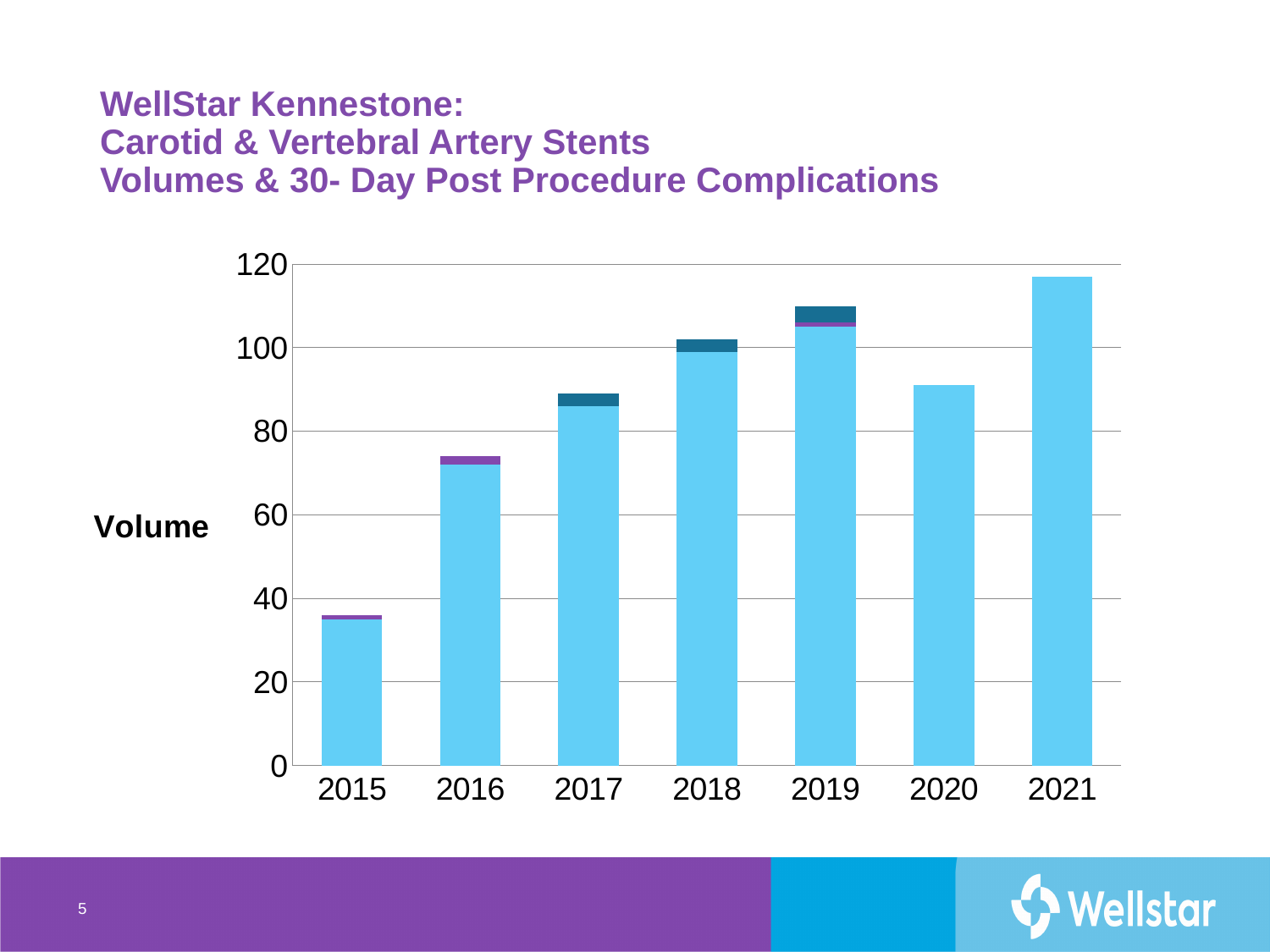
Is the value for 2021 greater or less than 100? greater Do the bars rise or fall from 2015 to 2019? rise What is the title of the vertical axis? Volume Is the value for 2015 greater or less than 40? less Is the value for 2020 greater or less than 100? less What kind of chart is shown on the slide? bar chart Which is larger, the bar for 2019 or the bar for 2020? 2019 Which year has the lowest total bar? 2015 Which year has the highest total bar? 2021 How many years are shown on the x axis of the chart? 7